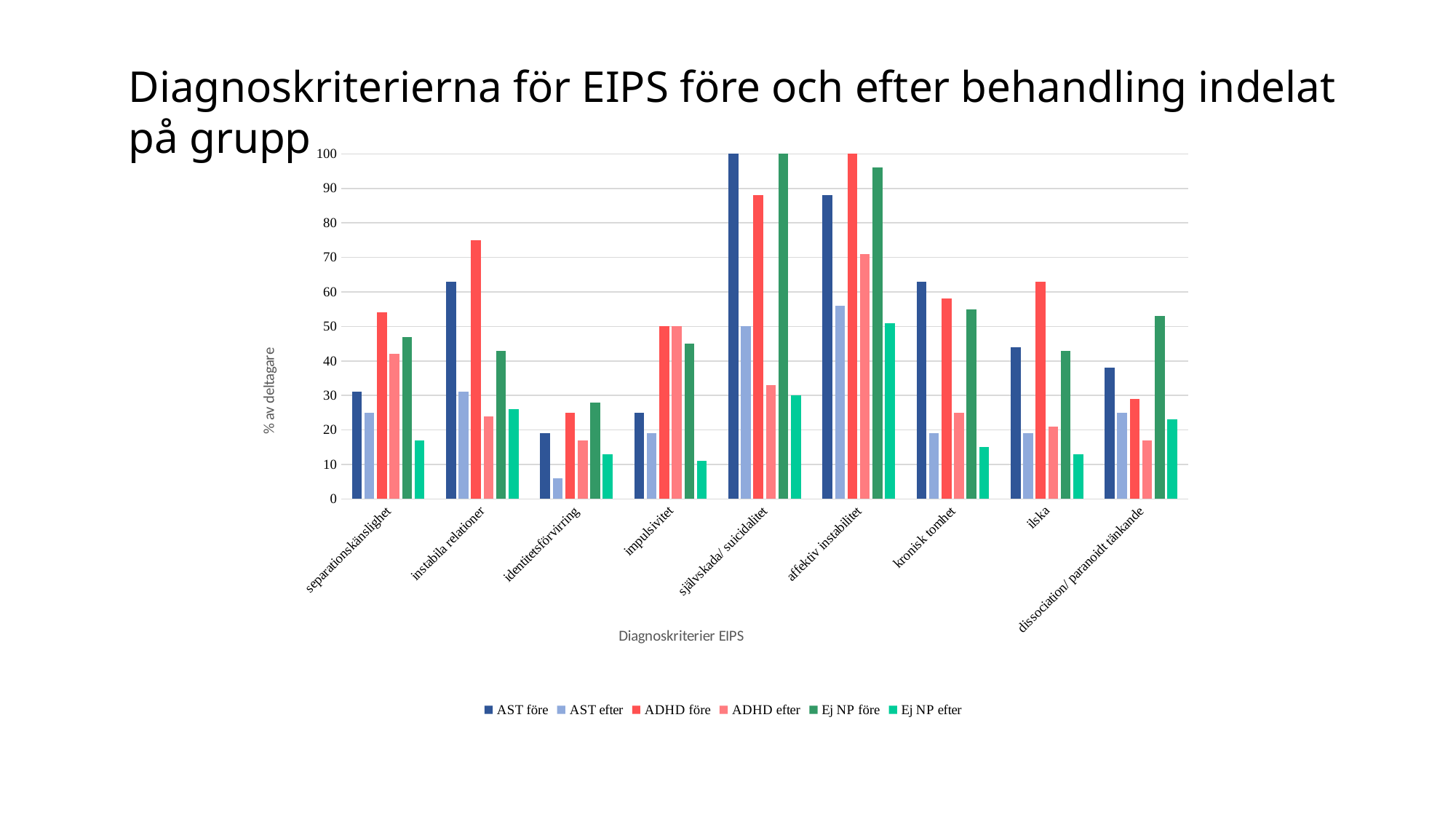
What is the value for AST före in the självskada/ suicidalitet category? 100 What is the value for ADHD före in the affektiv instabilitet category? 100 Is the value for AST efter in the identitetsförvirring category greater or less than 10? less Is the value for Ej NP före in the kronisk tomhet category greater or less than 50? greater In the instabila relationer category, which is larger: AST före or AST efter? AST före Which series has the highest value in the ilska category? ADHD före How many diagnostic criteria (categories) are shown on the x axis? 9 What is the label of the y axis? % av deltagare What kind of chart is shown on the slide? bar chart Which series has the highest value in the dissociation/ paranoidt tänkande category? Ej NP före Is the value for ADHD före in the instabila relationer category greater or less than 70? greater How many series does the legend list? 6